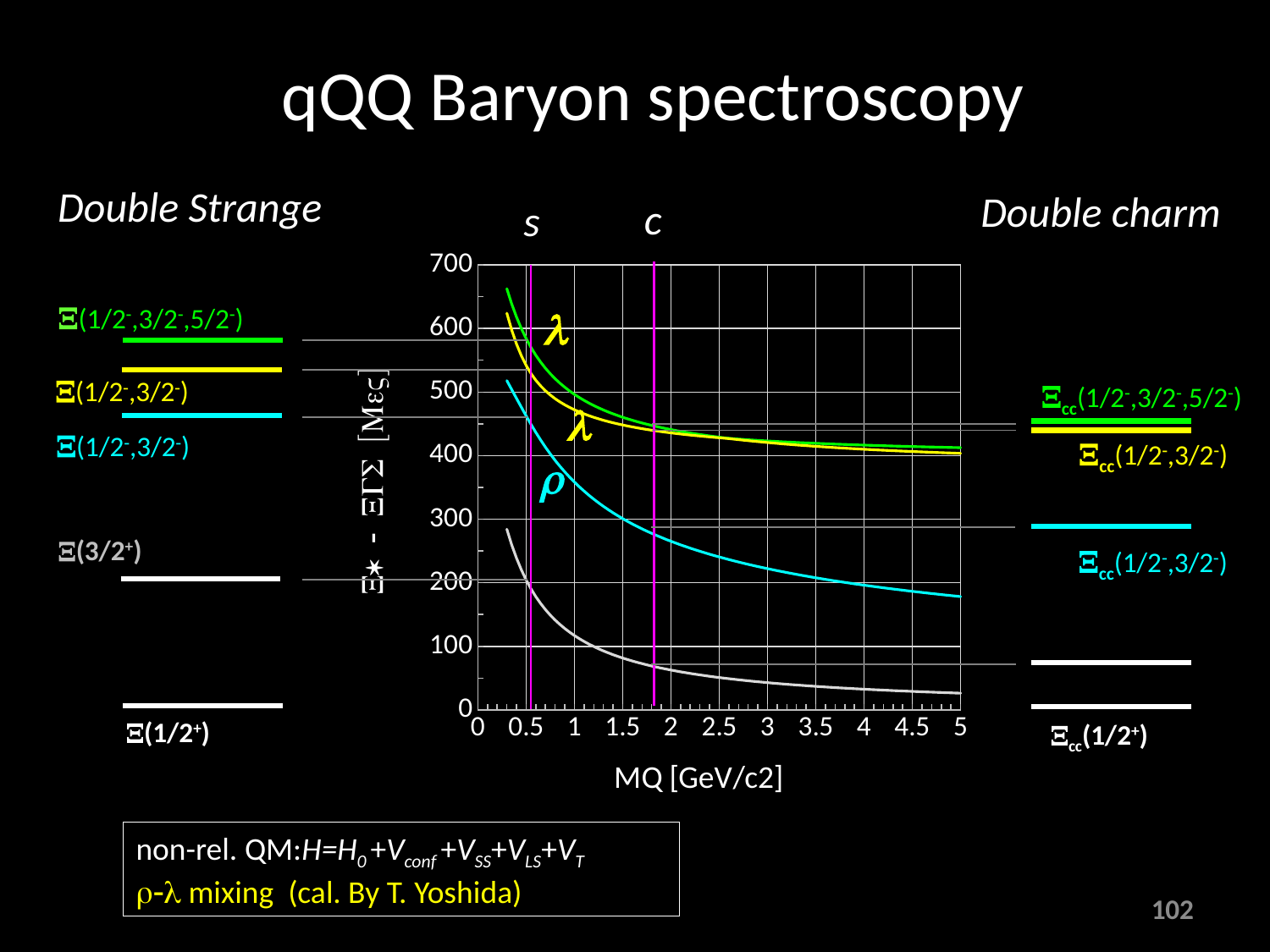
Is the value of the gray curve at the vertical line marked c greater or less than 100? less Is the value of the cyan (ρ) curve at MQ = 5 greater or less than 200? less Is the value of the green curve at MQ = 5 greater or less than 400? greater Which curve is the lowest across the whole range of MQ? the gray curve How many curves are plotted in the chart? 4 What kind of chart is shown on the slide? line chart What is the label of the x axis of the chart? MQ [GeV/c2] At MQ = 1, which is larger: the value of the green curve or the value of the cyan curve? the green curve What is the highest value shown on the y axis of the chart? 700 Do the plotted curves rise or fall as MQ increases along the x axis? fall